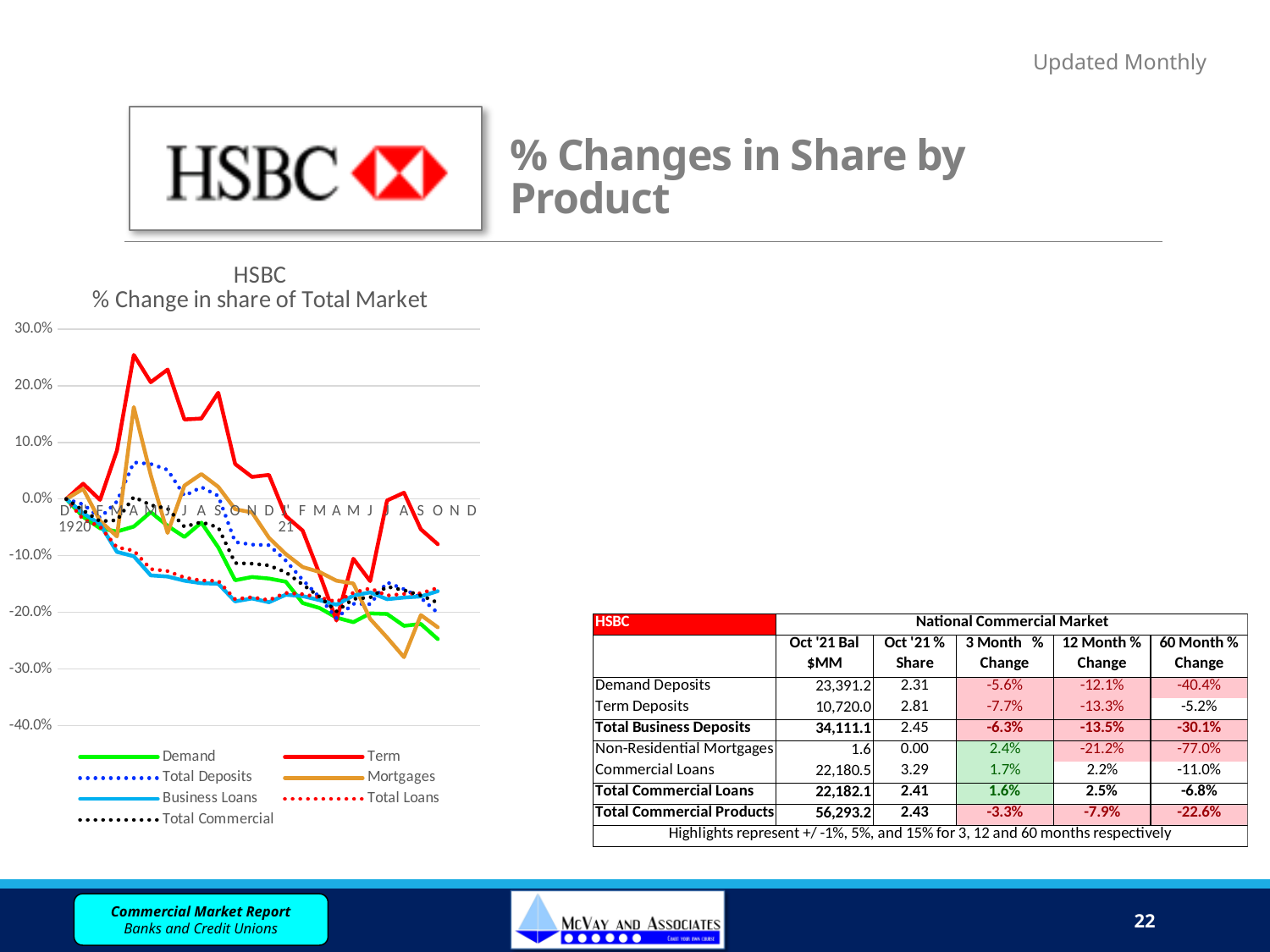
Which series reaches the highest value on the chart? Term Is the final value of the Business Loans series greater or less than -10.0%? less Is the peak value of the Term series greater or less than 20.0%? greater Is the peak value of the Mortgages series greater or less than 10.0%? greater What value do all the series share at the first point on the x axis (D '19)? 0.0% Which series reaches the lowest value on the chart? Mortgages How many series does the legend of the HSBC chart list? 7 What is the title of the chart on the slide? HSBC % Change in share of Total Market What kind of chart is shown on the slide? line chart Does the Demand series rise or fall overall from the start to the end of the x axis? fall